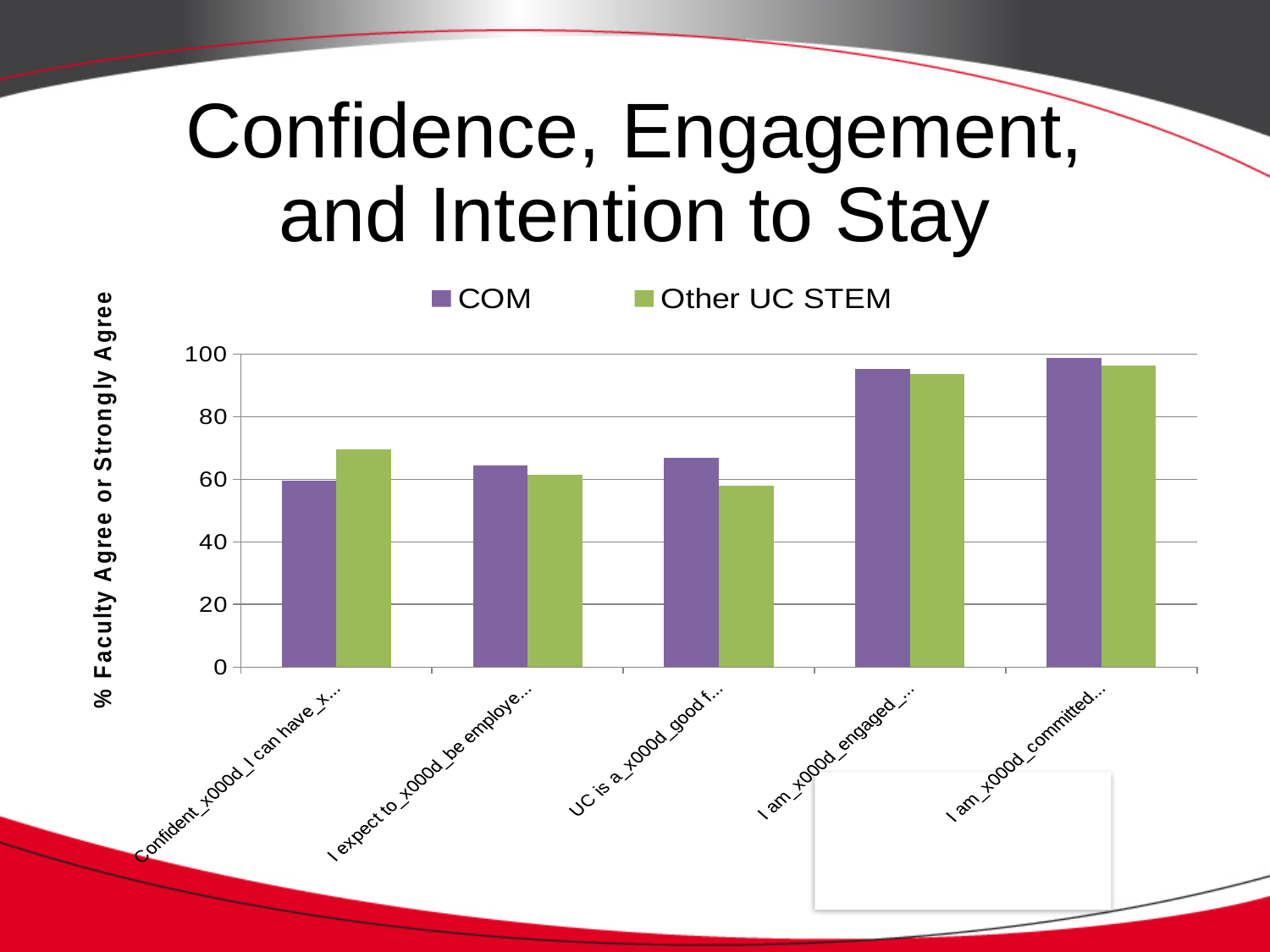
How many series does the legend list? 2 Is the COM value for the fourth category (I am engaged...) greater or less than 80? greater What kind of chart is shown on the slide? bar chart For the first category (Confident...), which series has the larger value, COM or Other UC STEM? Other UC STEM Is the Other UC STEM value for the first category (Confident...) greater or less than 60? greater What are the two series named in the legend? COM and Other UC STEM For the third category (UC is a good f...), which series has the larger value, COM or Other UC STEM? COM What is the title of the vertical axis? % Faculty Agree or Strongly Agree Is the Other UC STEM value for the third category (UC is a good f...) greater or less than 60? less How many categories are plotted along the x axis? 5 Which category has the lowest COM value? the first category (Confident...)